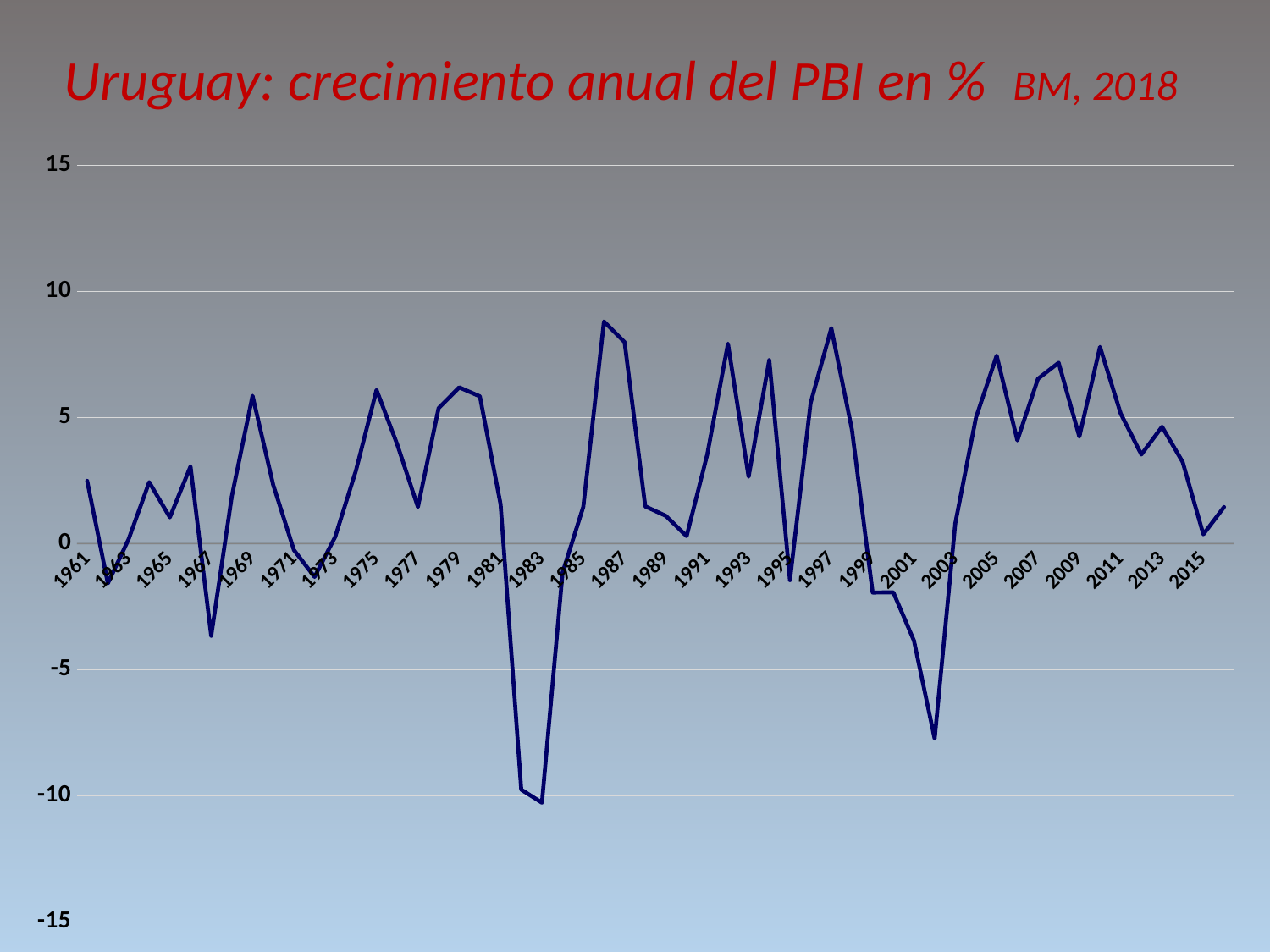
Which year has the lower value, 1983 or 2002? 1983 Is the value for 2001 greater or less than 0? less What is the title of the chart? Uruguay: crecimiento anual del PBI en % Is the value for 2002 greater or less than -5? less Is the value for 1967 greater or less than 0? less What kind of chart is shown on the slide? line chart What are the lowest and highest values shown on the vertical axis? -15 and 15 Which year has the higher value, 1986 or 1989? 1986 Do the values rise or fall from 2011 to 2015? fall